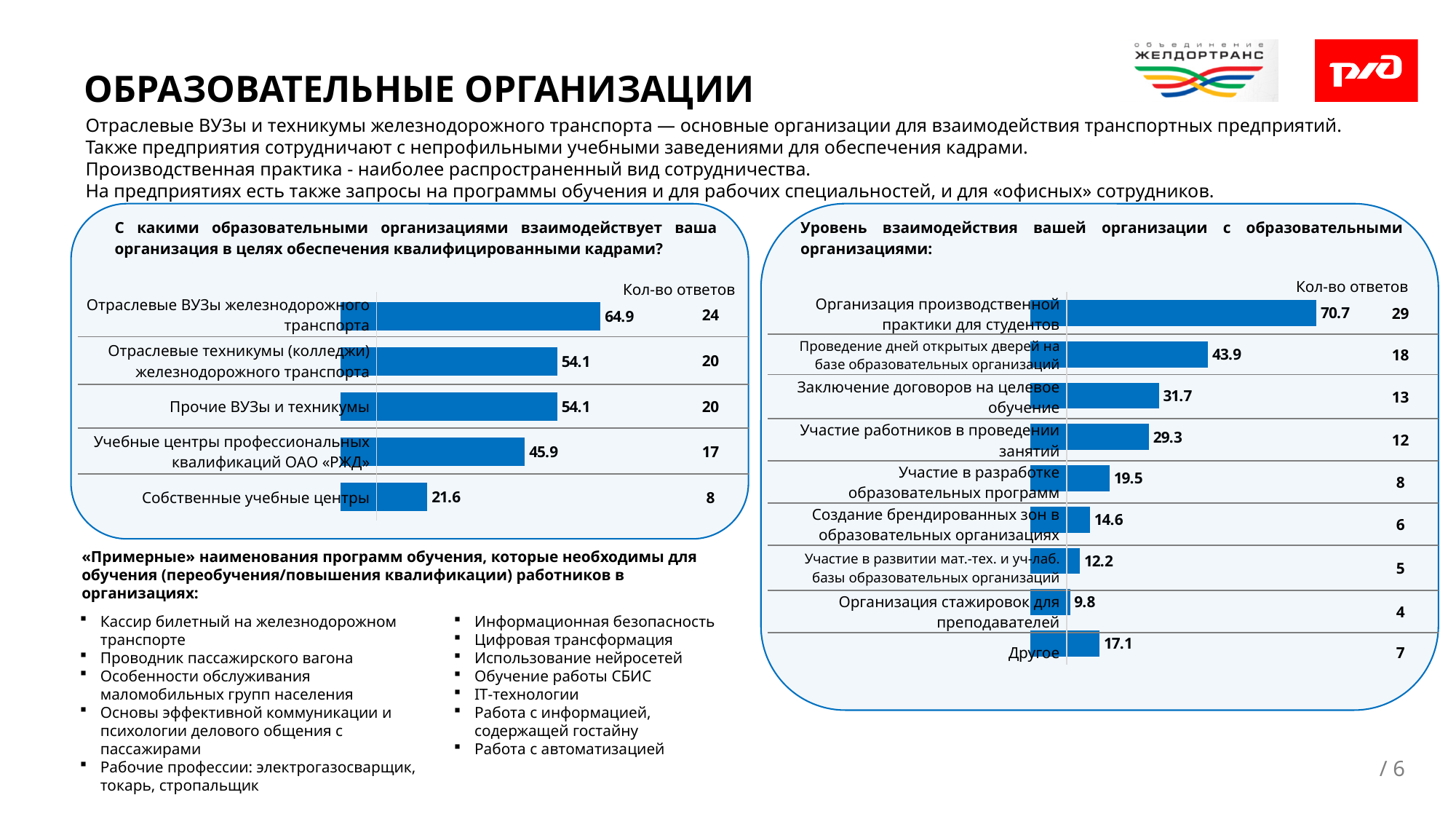
In the right chart, which category has the lowest value? Организация стажировок для преподавателей How many categories does the right chart show? 9 In the left chart, what is the difference between the values for «Отраслевые ВУЗы железнодорожного транспорта» and «Учебные центры профессиональных квалификаций ОАО «РЖД»»? 19 In the left chart, how many answers (Кол-во ответов) are shown for «Собственные учебные центры»? 8 What type of chart is used in the right chart? Bar chart In the right chart, how many answers (Кол-во ответов) are shown for «Проведение дней открытых дверей на базе образовательных организаций»? 18 In the right chart, which is larger: the value for «Другое» or the value for «Создание брендированных зон в образовательных организациях»? Другое In the left chart, what is the value for «Отраслевые ВУЗы железнодорожного транспорта»? 64.9 In the right chart, what is the value for «Заключение договоров на целевое обучение»? 31.7 In the left chart, which category has the lowest value? Собственные учебные центры In the right chart, which category has the highest value? Организация производственной практики для студентов How many categories does the left chart show? 5